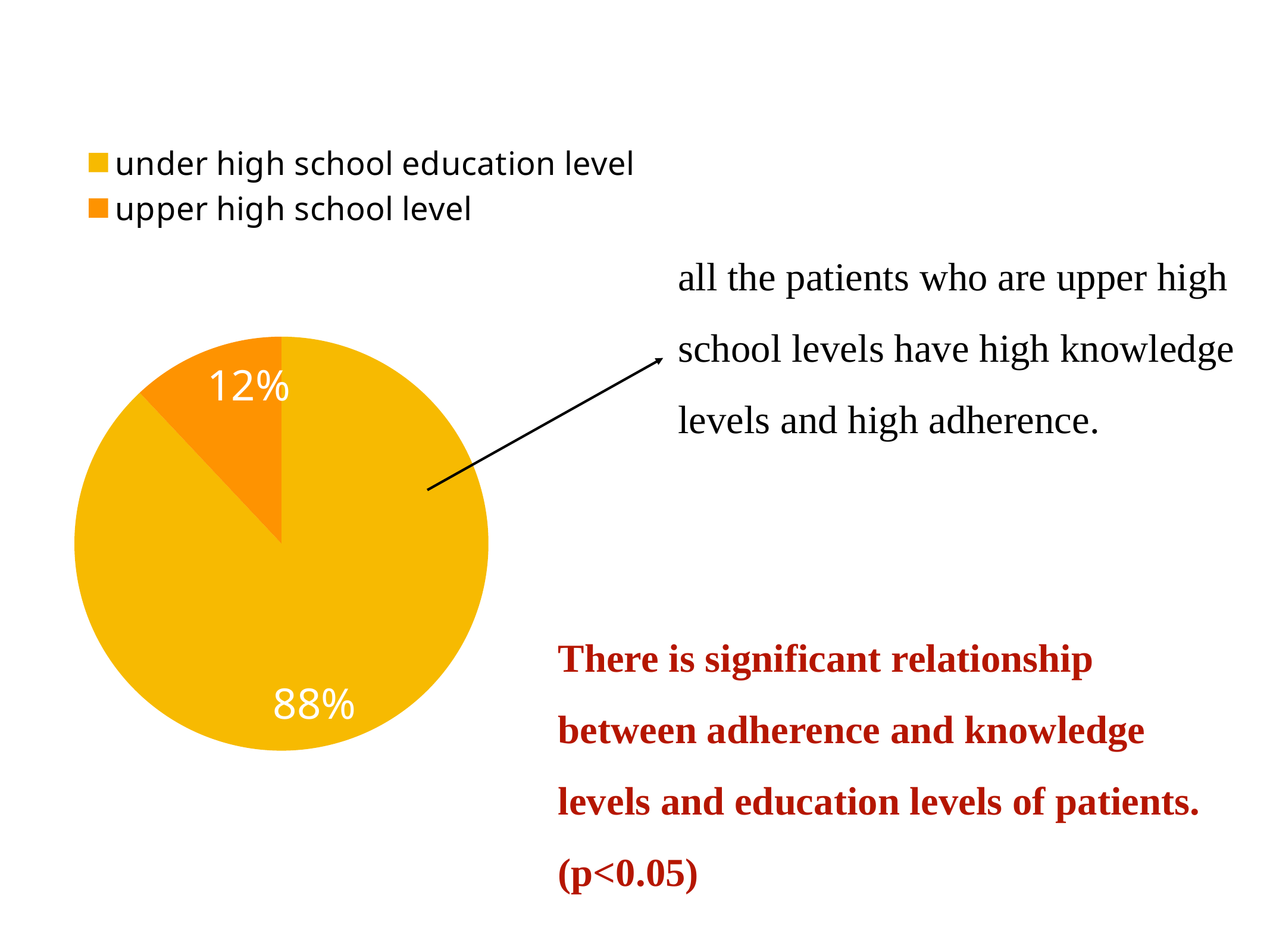
What kind of chart is shown on the slide? pie chart What is the difference in percentage points between the 'under high school education level' slice and the 'upper high school level' slice? 76 How many entries does the legend list? 2 Which is larger: the share for 'under high school education level' or for 'upper high school level'? under high school education level Which category has the largest share of the pie? under high school education level What percentage of the pie is labelled for 'under high school education level'? 88% Which category has the smallest share of the pie? upper high school level What is the share of the pie taken by the 'upper high school level' slice? 12% Which legend entry is shown in the yellow colour? under high school education level Which legend entry is shown in the darker orange colour? upper high school level How many slices does the pie chart have? 2 What percentage of the pie is labelled for 'upper high school level'? 12%